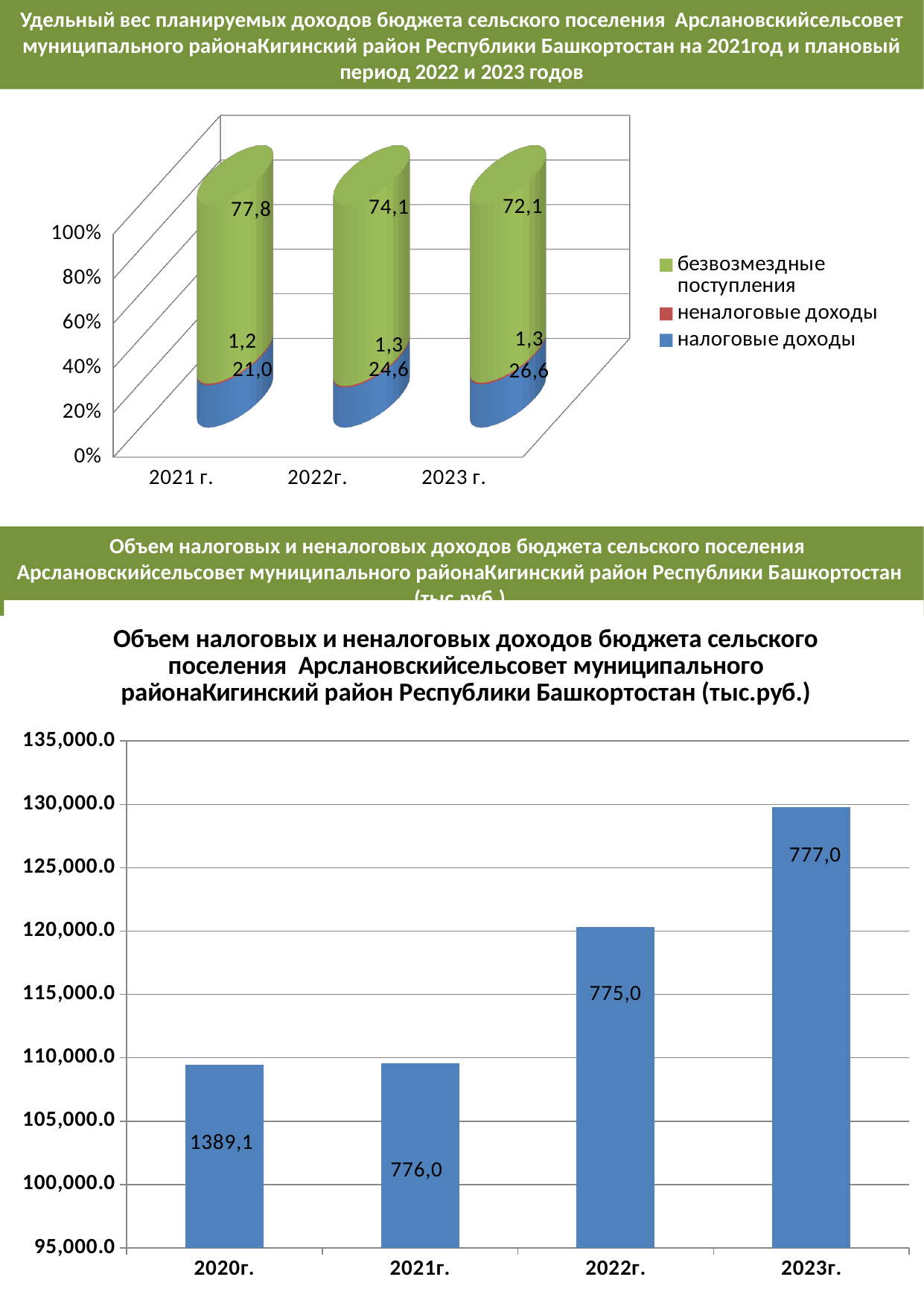
In the bottom chart, what is the data label for 2020г.? 1389,1 In the bottom chart, what is the data label for 2022г.? 775,0 What kind of chart is the top chart? stacked bar chart How many series does the legend of the top chart list? 3 In the top chart, does the share of налоговые доходы rise or fall from 2021 г. to 2023 г.? rise In the top chart, in which year is the share of безвозмездные поступления highest? 2021 г. In the top chart, what is the value for неналоговые доходы in 2022г.? 1,3 In the top chart, what is the value for налоговые доходы in 2023 г.? 26,6 In the top chart, what is the value for безвозмездные поступления in 2021 г.? 77,8 How many years are shown on the x axis of the bottom chart? 4 In the top chart, what is the difference between the налоговые доходы values for 2023 г. and 2021 г.? 5,6 In the top chart, in which year is the share of налоговые доходы lowest? 2021 г.